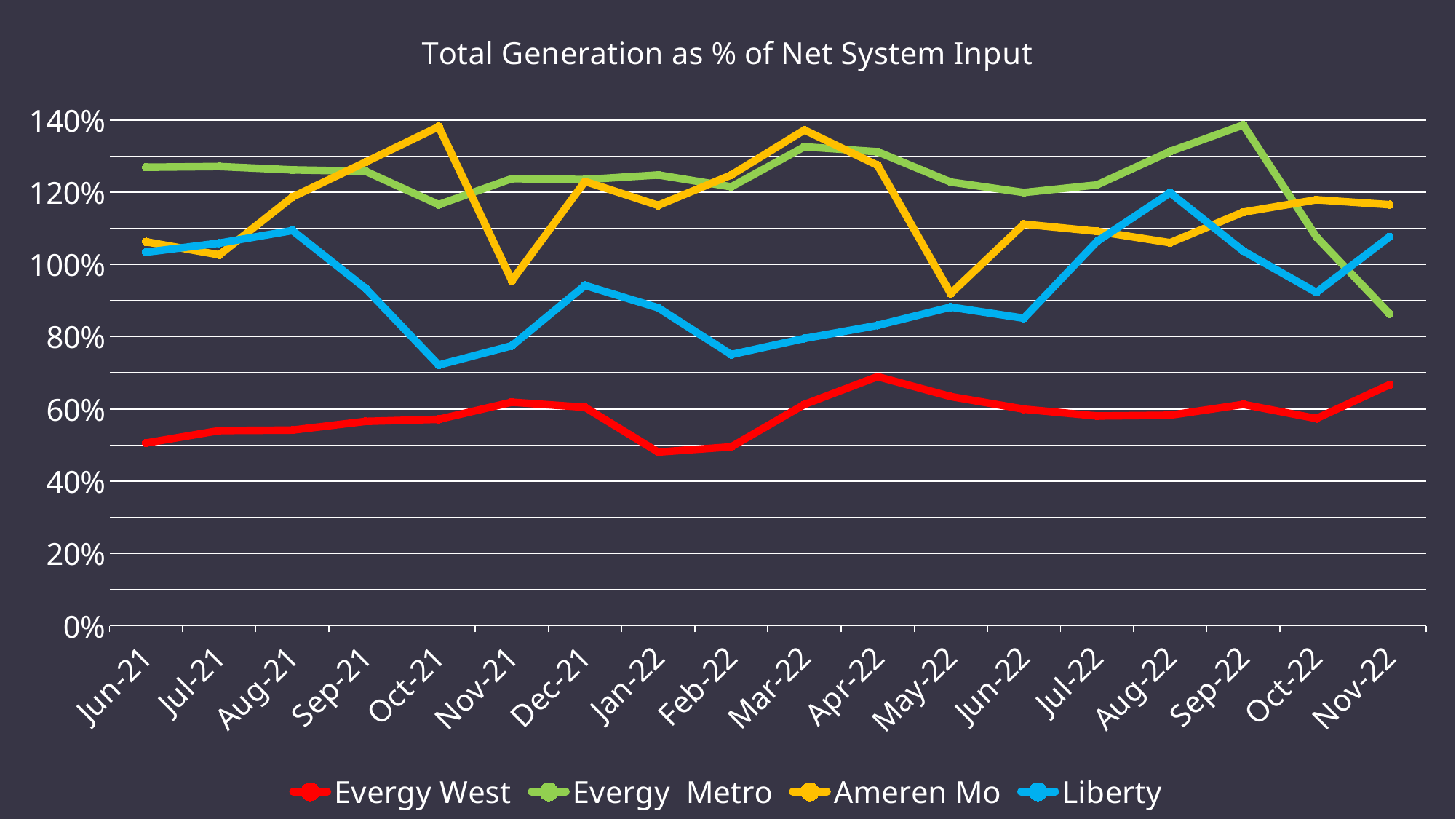
What is the title of the chart? Total Generation as % of Net System Input Is the value for Liberty in Oct-21 greater or less than 80%? less Which series has the lowest value in Jun-21? Evergy West Is the value for Evergy Metro in Nov-22 greater or less than 100%? less How many series does the legend list? 4 Is the value for Ameren Mo in Oct-21 greater or less than 120%? greater In Jun-21, which is larger: Evergy Metro or Evergy West? Evergy Metro What type of chart is shown on the slide? line chart How many months are plotted along the x axis? 18 In Aug-22, which is larger: Liberty or Ameren Mo? Liberty Which series has the highest value in Nov-22? Ameren Mo